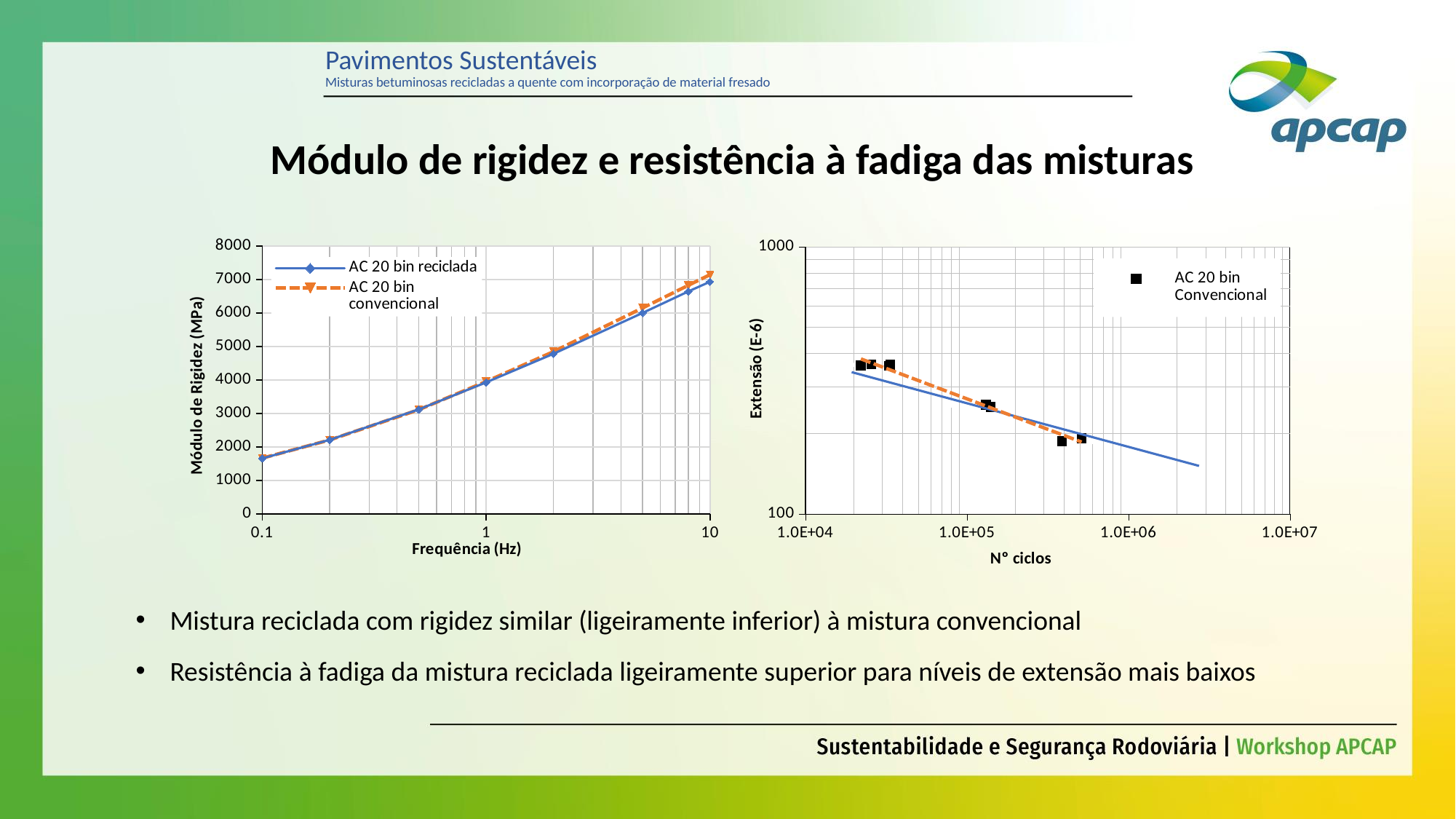
How many series does the legend of the right chart (Extensão vs N° ciclos) list? 1 What kind of chart is the right chart showing Extensão against N° ciclos? scatter chart What kind of chart is the left chart showing Módulo de Rigidez against Frequência? line chart In the left chart, is the Módulo de Rigidez of AC 20 bin reciclada at 1 Hz greater or less than 3000? greater What is the label of the x axis of the right chart? N° ciclos In the left chart, does the Módulo de Rigidez rise or fall as Frequência increases? rise How many series does the legend of the left chart (Módulo de Rigidez) list? 2 In the left chart, is the Módulo de Rigidez of AC 20 bin convencional at 0.1 Hz greater or less than 2000? less In the right chart, does Extensão rise or fall as N° ciclos increases? fall In the left chart, at 10 Hz, which series has the higher Módulo de Rigidez, AC 20 bin reciclada or AC 20 bin convencional? AC 20 bin convencional In the left chart, is the Módulo de Rigidez of AC 20 bin reciclada at 10 Hz greater or less than 6000? greater What is the label of the y axis of the left chart? Módulo de Rigidez (MPa)